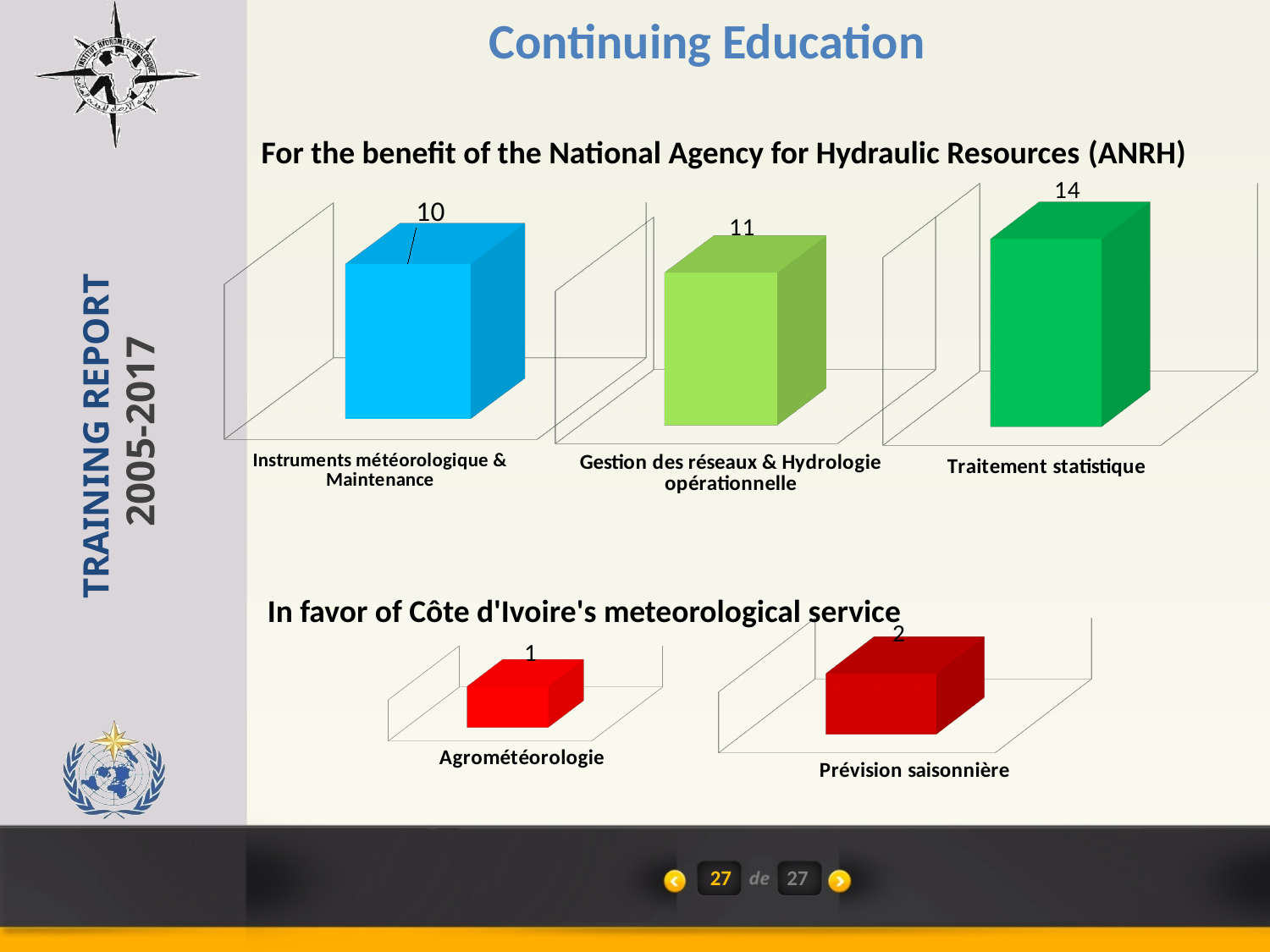
In the chart in favor of Côte d'Ivoire's meteorological service, how many categories are shown? 2 In the chart for the benefit of the National Agency for Hydraulic Resources (ANRH), how many categories are shown? 3 In the chart for the benefit of the National Agency for Hydraulic Resources (ANRH), what is the value for Traitement statistique? 14 In the chart for the benefit of the National Agency for Hydraulic Resources (ANRH), which category has the lowest value? Instruments météorologique & Maintenance In the chart in favor of Côte d'Ivoire's meteorological service, what is the value for Prévision saisonnière? 2 In the chart in favor of Côte d'Ivoire's meteorological service, which is larger, Agrométéorologie or Prévision saisonnière? Prévision saisonnière In the chart in favor of Côte d'Ivoire's meteorological service, what is the value for Agrométéorologie? 1 In the chart for the benefit of the National Agency for Hydraulic Resources (ANRH), what is the difference between the values for Traitement statistique and Instruments météorologique & Maintenance? 4 In the chart for the benefit of the National Agency for Hydraulic Resources (ANRH), which category has the highest value? Traitement statistique In the chart for the benefit of the National Agency for Hydraulic Resources (ANRH), what is the value for Instruments météorologique & Maintenance? 10 What kind of chart is the chart for the benefit of the National Agency for Hydraulic Resources (ANRH)? Bar chart In the chart for the benefit of the National Agency for Hydraulic Resources (ANRH), what is the value for Gestion des réseaux & Hydrologie opérationnelle? 11